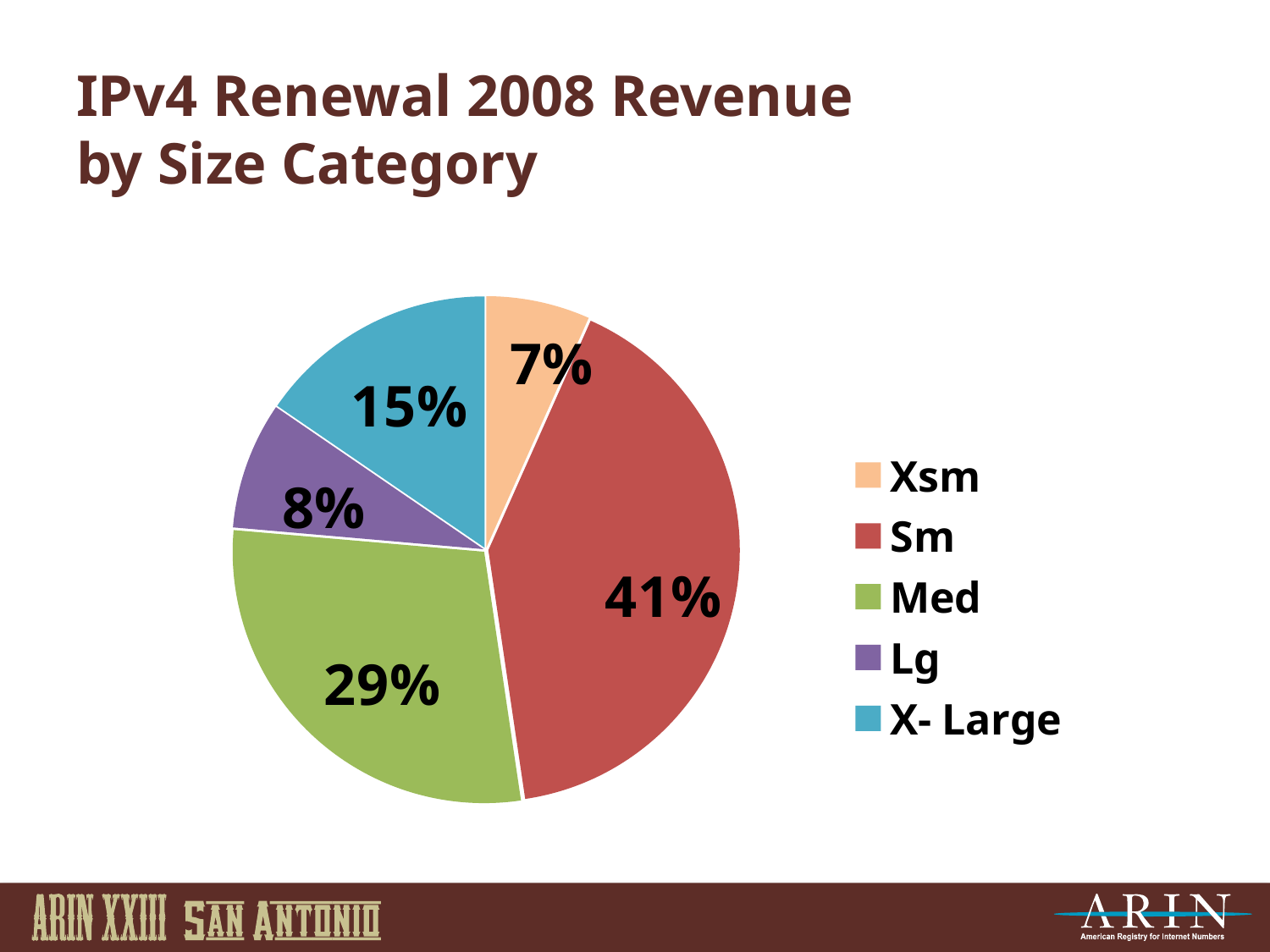
What colour is the Med slice in the pie chart? Green What is the value shown for the X- Large slice? 15% How many size categories are shown in the pie chart? 5 What percentage of the pie is the Med slice? 29% What is the value shown for the Lg slice? 8% What is the difference in percentage points between the Sm and Med slices? 12 What share of IPv4 Renewal 2008 Revenue does the Sm category account for? 41% What is the value shown for the Xsm slice? 7% What kind of chart is shown on the slide? Pie chart Which size category has the smallest share of revenue? Xsm Which is larger, the X- Large slice or the Lg slice? X- Large Which size category has the largest share of revenue? Sm